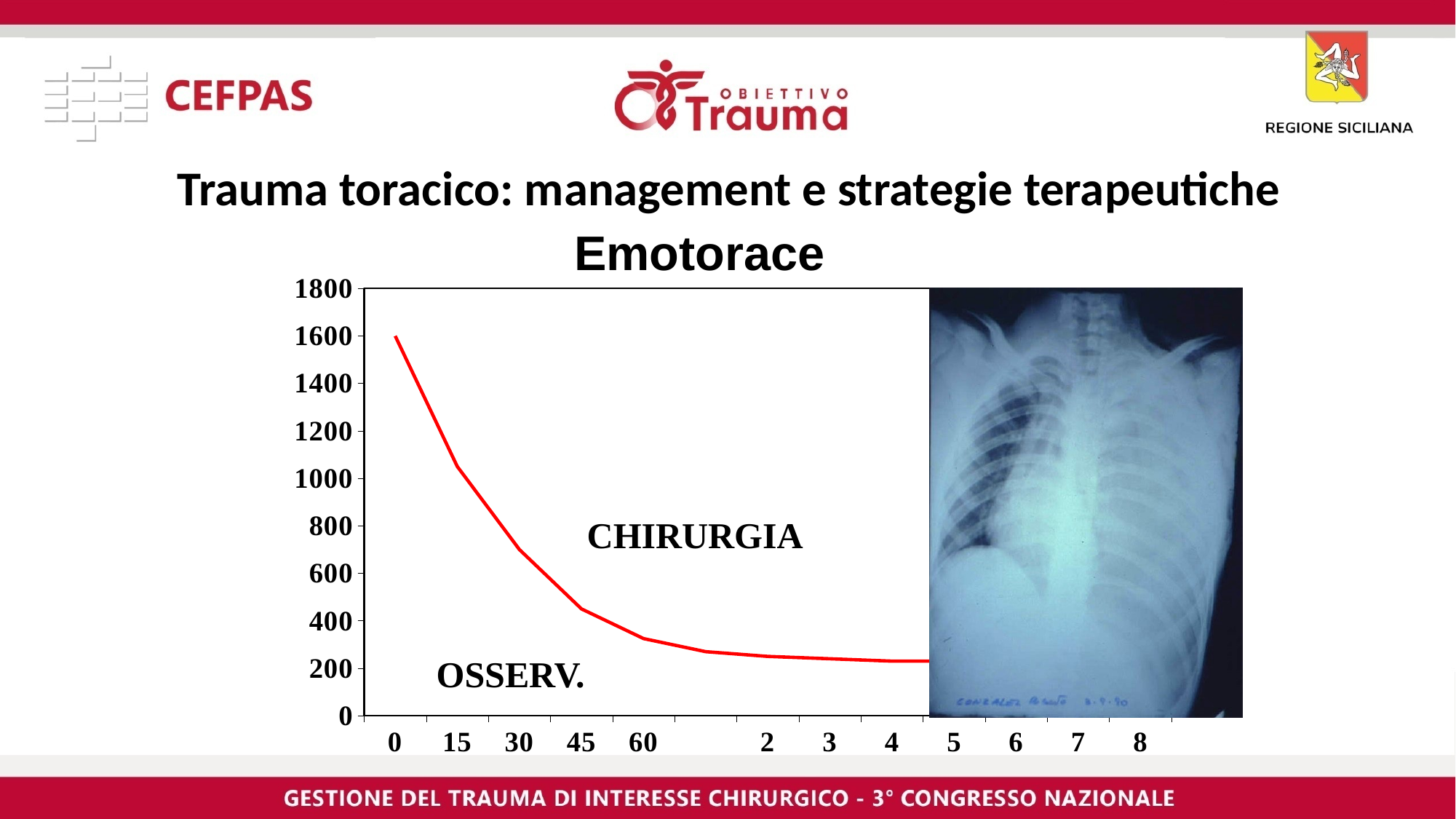
Do the values of the red line rise or fall as you move along the x axis? fall Is the value of the line at x = 15 greater or less than 1200? less What is the title of the chart? Emotorace What kind of chart is shown on the slide? line chart Is the value of the line at x = 45 greater or less than 600? less Is the value of the line at x = 60 greater or less than 600? less At which x-axis label does the line reach its highest value? 0 What is the highest value shown on the y axis of the chart? 1800 What two text labels are written inside the plot area of the chart? CHIRURGIA and OSSERV.